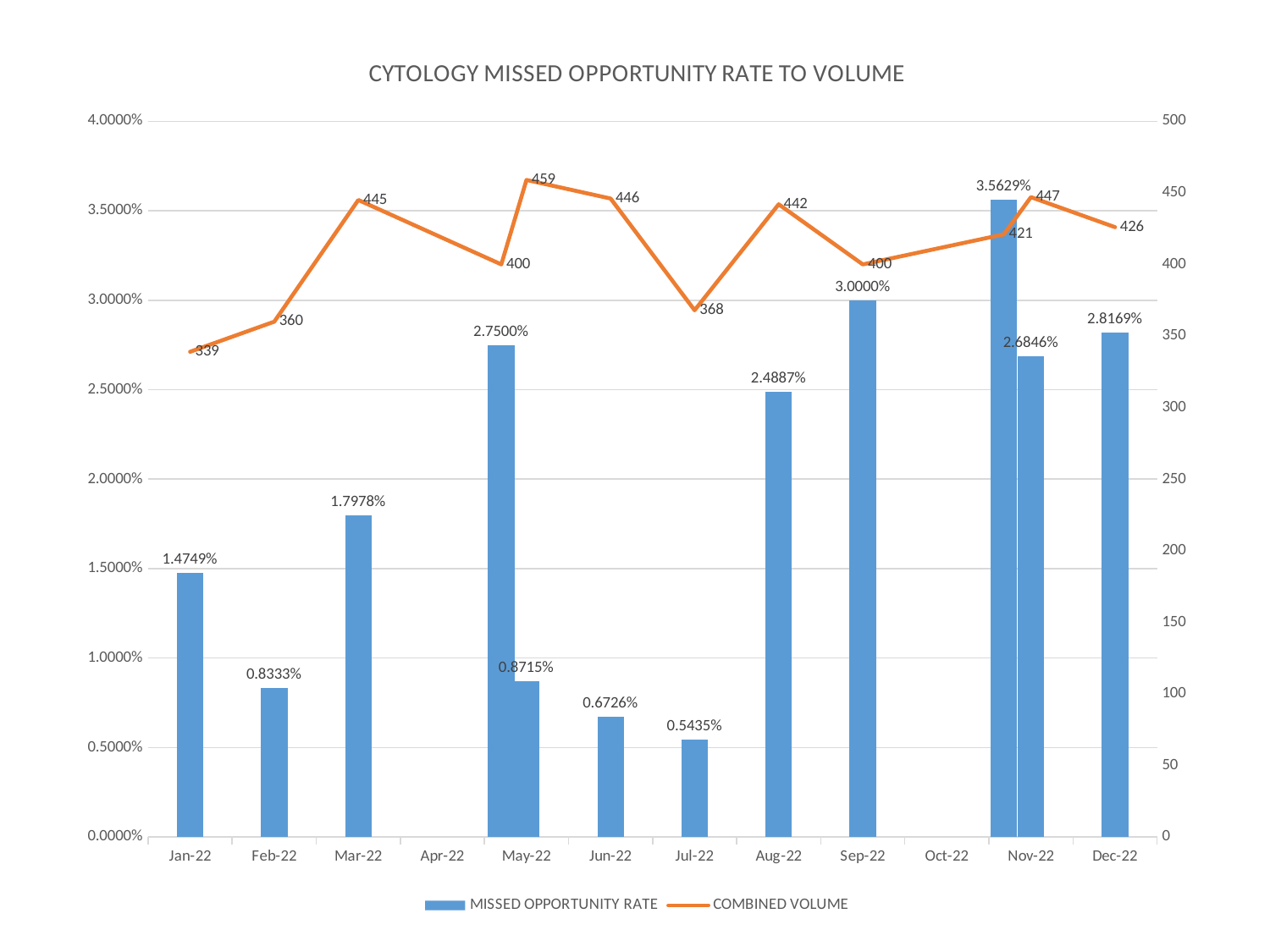
What is the highest missed opportunity rate shown on the chart? 3.5629% How many months are labelled on the x axis? 12 What is the missed opportunity rate for Sep-22? 3.0000% How many series does the legend list? 2 What is the title of the chart? CYTOLOGY MISSED OPPORTUNITY RATE TO VOLUME What is the lowest combined volume value shown on the chart? 339 What is the combined volume for Jul-22? 368 Which has the higher missed opportunity rate, Jan-22 or Feb-22? Jan-22 What is the lowest missed opportunity rate shown on the chart? 0.5435% What is the difference between the missed opportunity rate for Sep-22 and Aug-22? 0.5113% What is the missed opportunity rate for Jan-22? 1.4749% What is the combined volume for Mar-22? 445